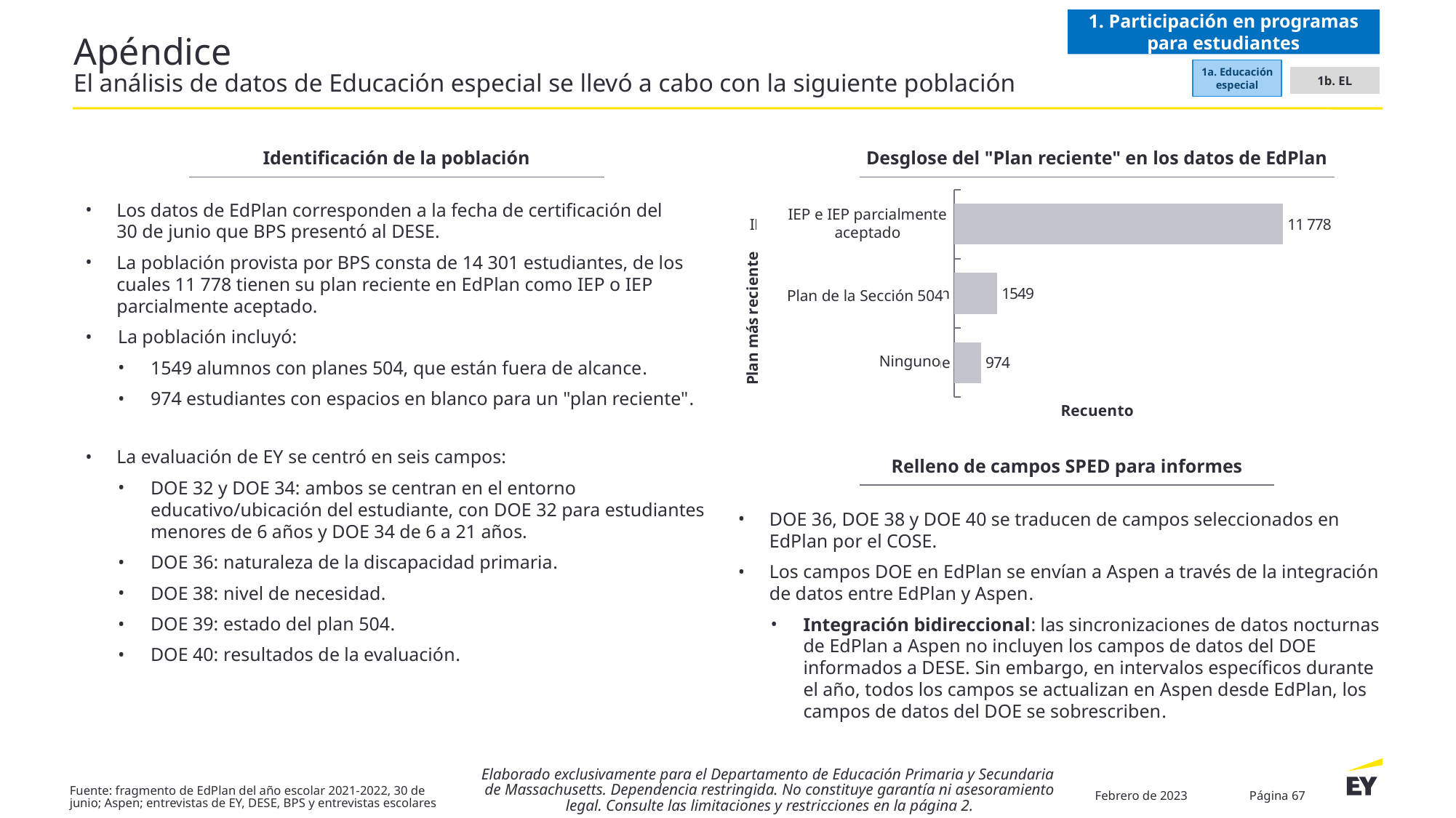
Which category has the lowest value in the chart? Ninguno What is the label of the horizontal axis of the chart? Recuento What is the difference between the values for "Plan de la Sección 504" and "Ninguno"? 575 How many categories are shown in the chart? 3 What is the value for "Plan de la Sección 504" in the chart? 1549 What is the value for "IEP e IEP parcialmente aceptado" in the chart? 11 778 Which category has the highest value in the chart? IEP e IEP parcialmente aceptado What is the title of the chart on the slide? Desglose del "Plan reciente" en los datos de EdPlan Which is larger, the value for "Plan de la Sección 504" or the value for "Ninguno"? Plan de la Sección 504 What is the difference between the values for "IEP e IEP parcialmente aceptado" and "Plan de la Sección 504"? 10 229 What kind of chart is shown on the slide? Bar chart What is the value for "Ninguno" in the chart? 974